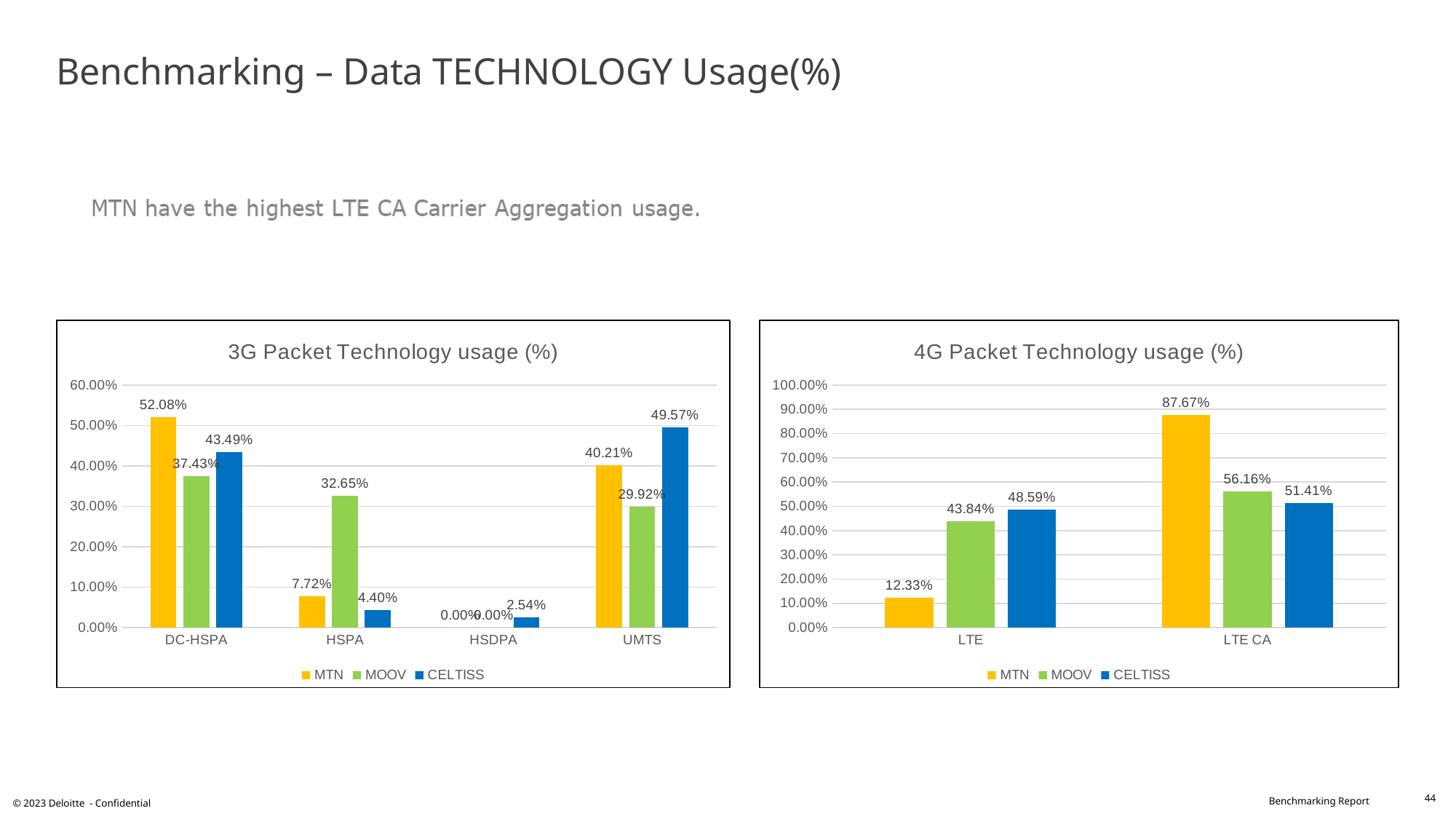
In the '3G Packet Technology usage (%)' chart, what is the value for CELTISS at UMTS? 49.57% How many series does the legend of the '4G Packet Technology usage (%)' chart list? 3 In the '3G Packet Technology usage (%)' chart, which operator has the lowest value at HSPA? CELTISS In the '3G Packet Technology usage (%)' chart, what is the difference between CELTISS and MOOV at DC-HSPA? 6.06% In the '4G Packet Technology usage (%)' chart, which operator has the lowest value at LTE? MTN In the '4G Packet Technology usage (%)' chart, which is larger at LTE: MOOV or CELTISS? CELTISS In the '3G Packet Technology usage (%)' chart, how many technology categories are shown on the x axis? 4 What type of chart is the '3G Packet Technology usage (%)' chart? Bar chart In the '3G Packet Technology usage (%)' chart, what is the value for MTN at DC-HSPA? 52.08% In the '4G Packet Technology usage (%)' chart, what is the difference between MTN and MOOV at LTE CA? 31.51% In the '4G Packet Technology usage (%)' chart, what is the value for MTN at LTE CA? 87.67% In the '3G Packet Technology usage (%)' chart, which operator has the highest value at HSPA? MOOV